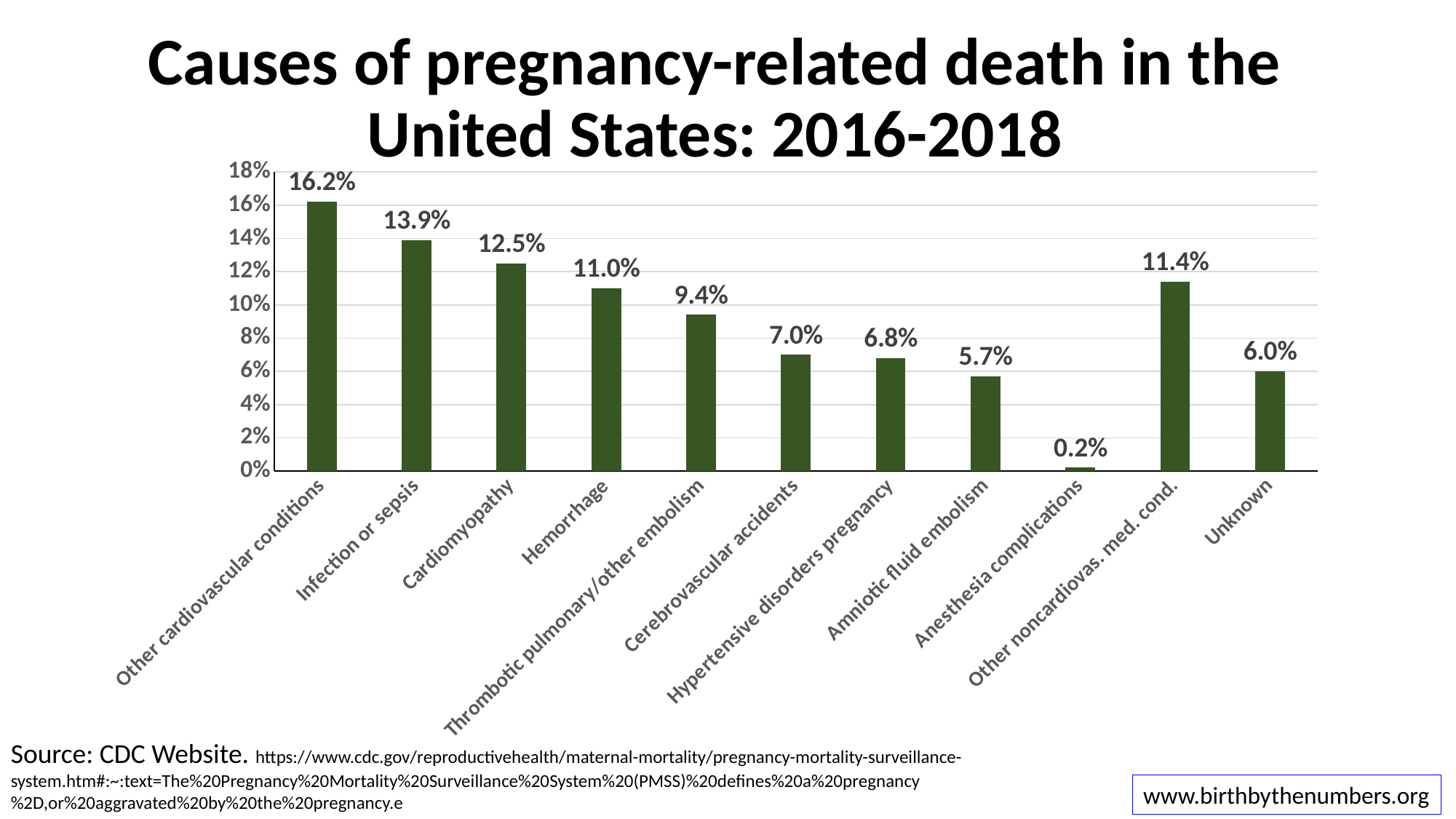
What is the highest value labelled on the vertical axis? 18% Which is larger, the value for Cerebrovascular accidents or the value for Amniotic fluid embolism? Cerebrovascular accidents How many causes of death are shown in the chart? 11 What is the value shown for Cardiomyopathy? 12.5% What is the title of the chart? Causes of pregnancy-related death in the United States: 2016-2018 Is the value for Thrombotic pulmonary/other embolism greater or less than 10%? less What is the difference between the values for Infection or sepsis and Unknown? 7.9% What percentage of pregnancy-related deaths is attributed to Hemorrhage? 11.0% What type of chart is shown on the slide? bar chart Which cause has the highest percentage? Other cardiovascular conditions What is the value shown for Other noncardiovas. med. cond.? 11.4% Which cause has the lowest percentage? Anesthesia complications